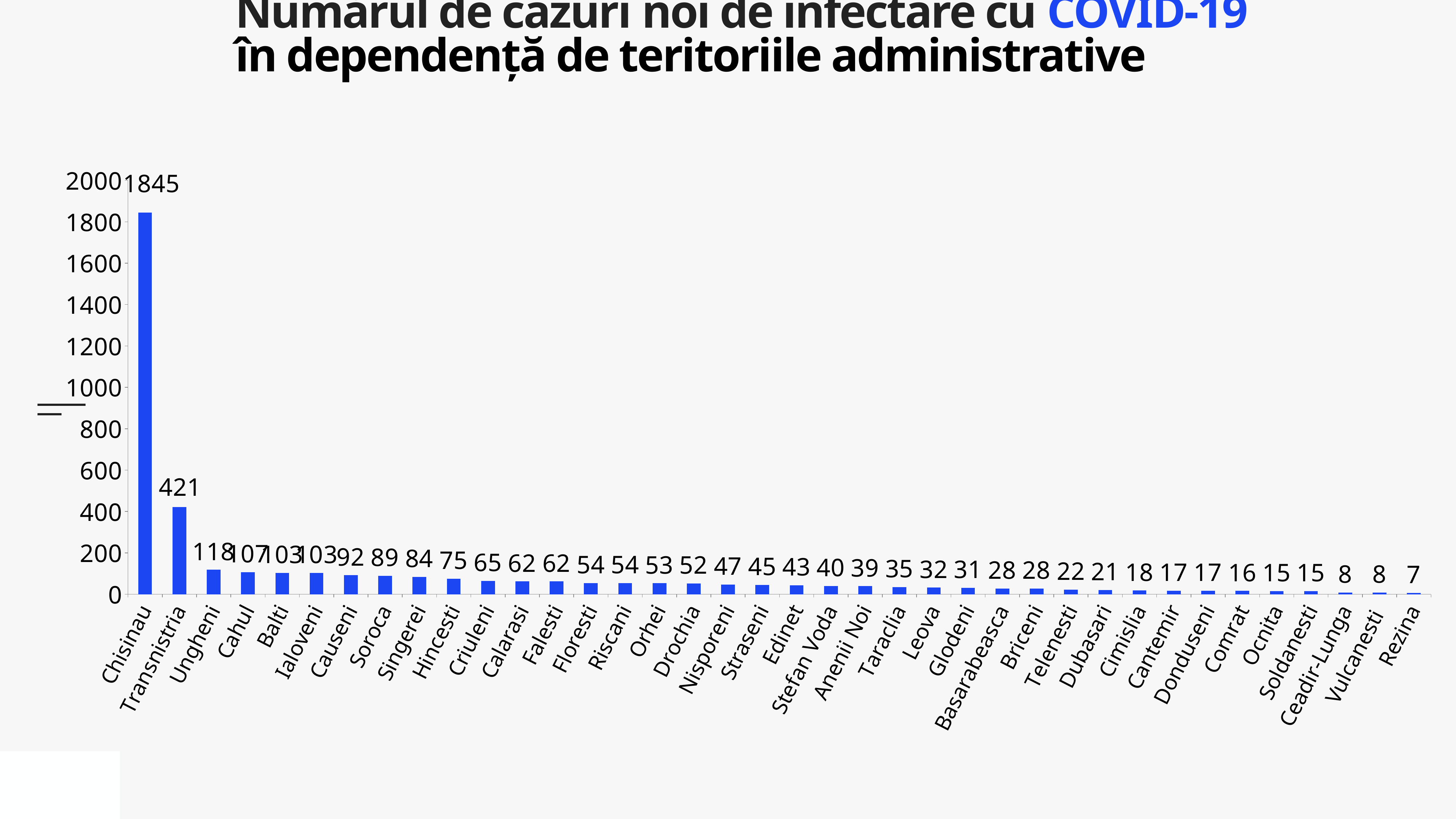
What is the difference between the values for Chisinau and Transnistria? 1424 Which category has the highest value? Chisinau What is the value for Taraclia? 35 What kind of chart is shown on the slide? bar chart What is the value for Chisinau? 1845 Is the value for Transnistria greater or less than 400? greater How many categories are shown on the x axis? 38 What is the value for Transnistria? 421 Which category has the lowest value? Rezina What is the value for Soroca? 89 Do the values rise or fall from left to right along the x axis? fall Which is larger, the value for Hincesti or the value for Orhei? Hincesti